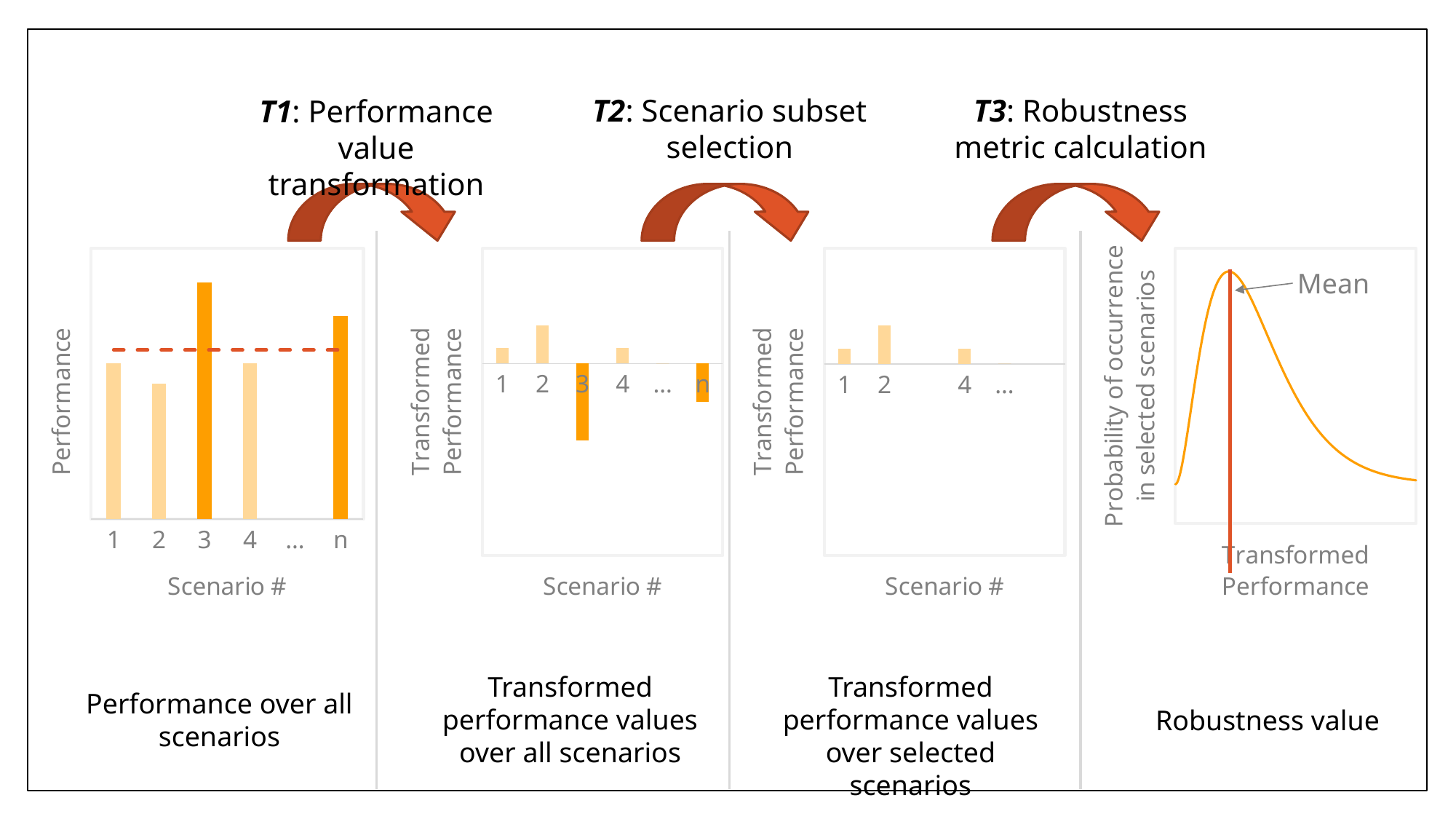
What kind of chart is the chart titled 'Performance over all scenarios'? Bar chart What kind of chart is the chart titled 'Robustness value'? Line chart In the chart titled 'Performance over all scenarios', which bar is taller: scenario 3 or scenario n? Scenario 3 What is the y-axis label of the chart titled 'Robustness value'? Probability of occurrence in selected scenarios In the chart titled 'Transformed performance values over selected scenarios', which scenario has the highest bar? 2 How many scenario bars are shown in the chart titled 'Transformed performance values over selected scenarios'? 3 In the chart titled 'Transformed performance values over all scenarios', which scenario has the lowest (most negative) bar? 3 In the chart titled 'Transformed performance values over all scenarios', is the bar for scenario n above or below zero? Below In the chart titled 'Performance over all scenarios', which scenario has the highest performance bar? 3 In the chart titled 'Transformed performance values over all scenarios', which scenario has the highest bar? 2 How many labelled scenario bars are shown in the chart titled 'Performance over all scenarios'? 5 In the chart titled 'Performance over all scenarios', which scenario has the lowest performance bar? 2